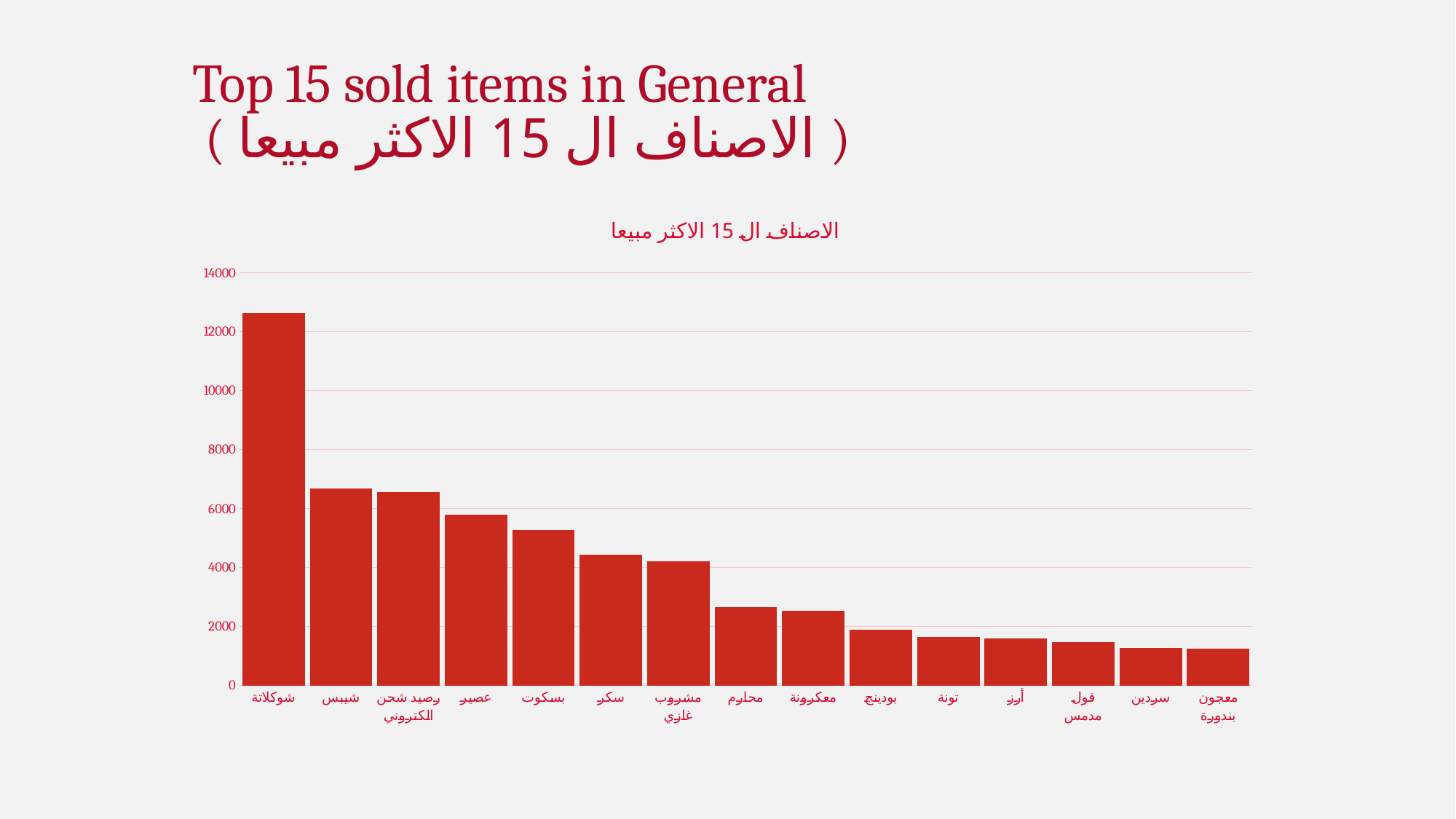
What kind of chart is shown on the slide? bar chart Is the value for بسكوت greater or less than 4000? greater Is the value for شوكلاتة greater or less than 12000? greater What is the title shown above the chart? الاصناف ال 15 الاكثر مبيعا How many categories (items) are plotted in the chart? 15 Is the value for شيبس greater or less than 6000? greater Do the values rise or fall moving from left to right along the x axis? fall Which item has the highest value in the chart? شوكلاتة Which has a larger value, شوكلاتة or شيبس? شوكلاتة